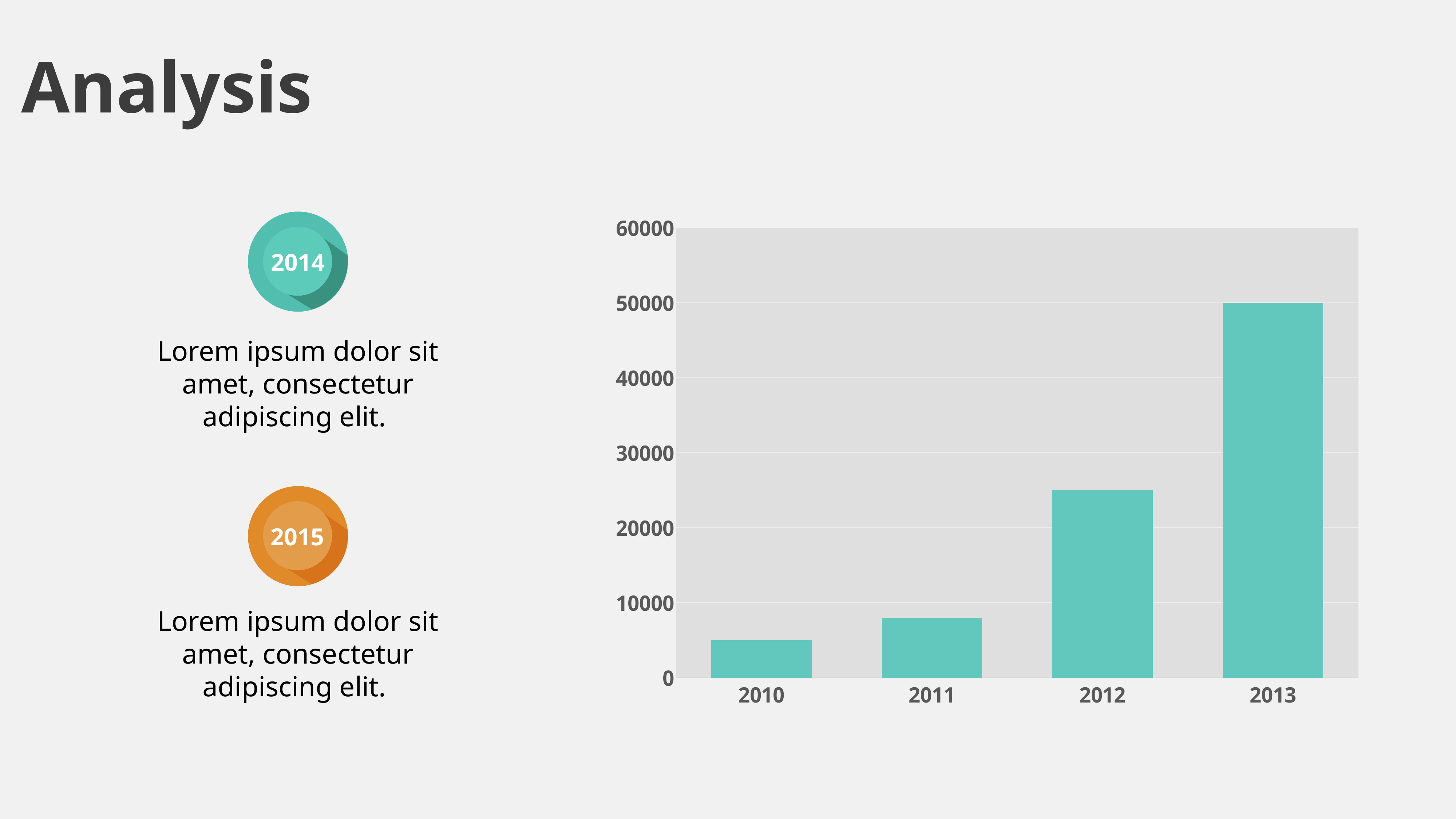
Do the values rise or fall from 2010 to 2013? rise What kind of chart is shown on the slide? bar chart How many years are shown on the x axis of the chart? 4 Which year has the lowest bar in the chart? 2010 What is the highest value shown on the chart's vertical axis? 60000 Which year has the highest bar in the chart? 2013 Which is larger, the value for 2011 or the value for 2012? 2012 Is the value for 2010 greater or less than 10000? less Is the value for 2011 greater or less than 10000? less What is the value for 2013 in the chart? 50000 Is the value for 2012 greater or less than 30000? less